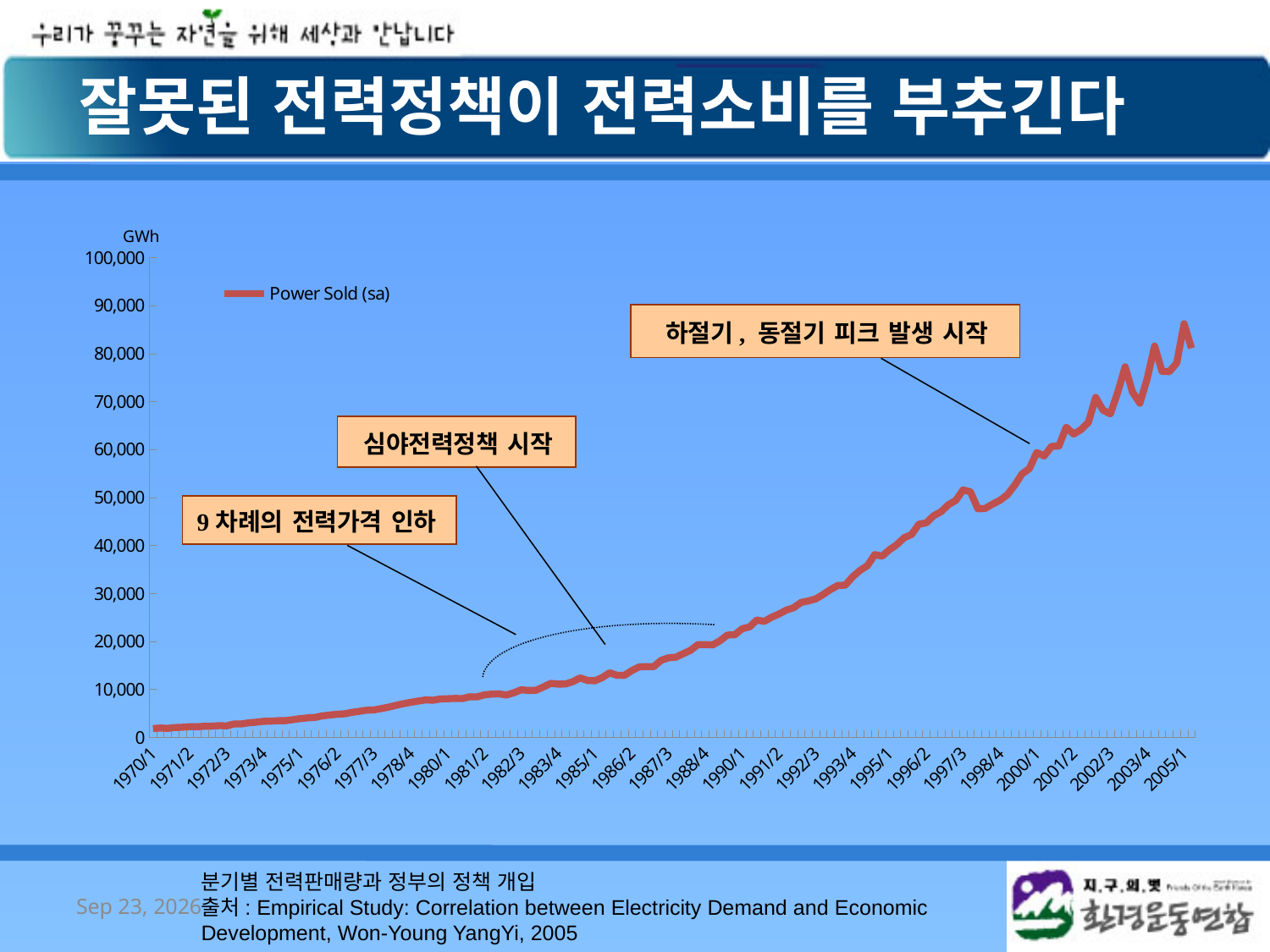
How many series does the chart legend list? 1 Do the values of Power Sold (sa) generally rise or fall from 1970/1 to 2005/1? rise Is the value for Power Sold (sa) at 2005/1 greater or less than 70,000? greater Which quarter on the x axis has the lowest value for Power Sold (sa)? 1970/1 Is the value for Power Sold (sa) at 1990/1 greater or less than 30,000? less What kind of chart is shown on the slide? line chart Is the value for Power Sold (sa) at 1970/1 greater or less than 10,000? less What is the highest value labelled on the y axis? 100,000 What is the name of the series shown in the chart legend? Power Sold (sa) Which is larger, the value for Power Sold (sa) at 1985/1 or at 1995/1? 1995/1 What unit is shown at the top of the y axis? GWh